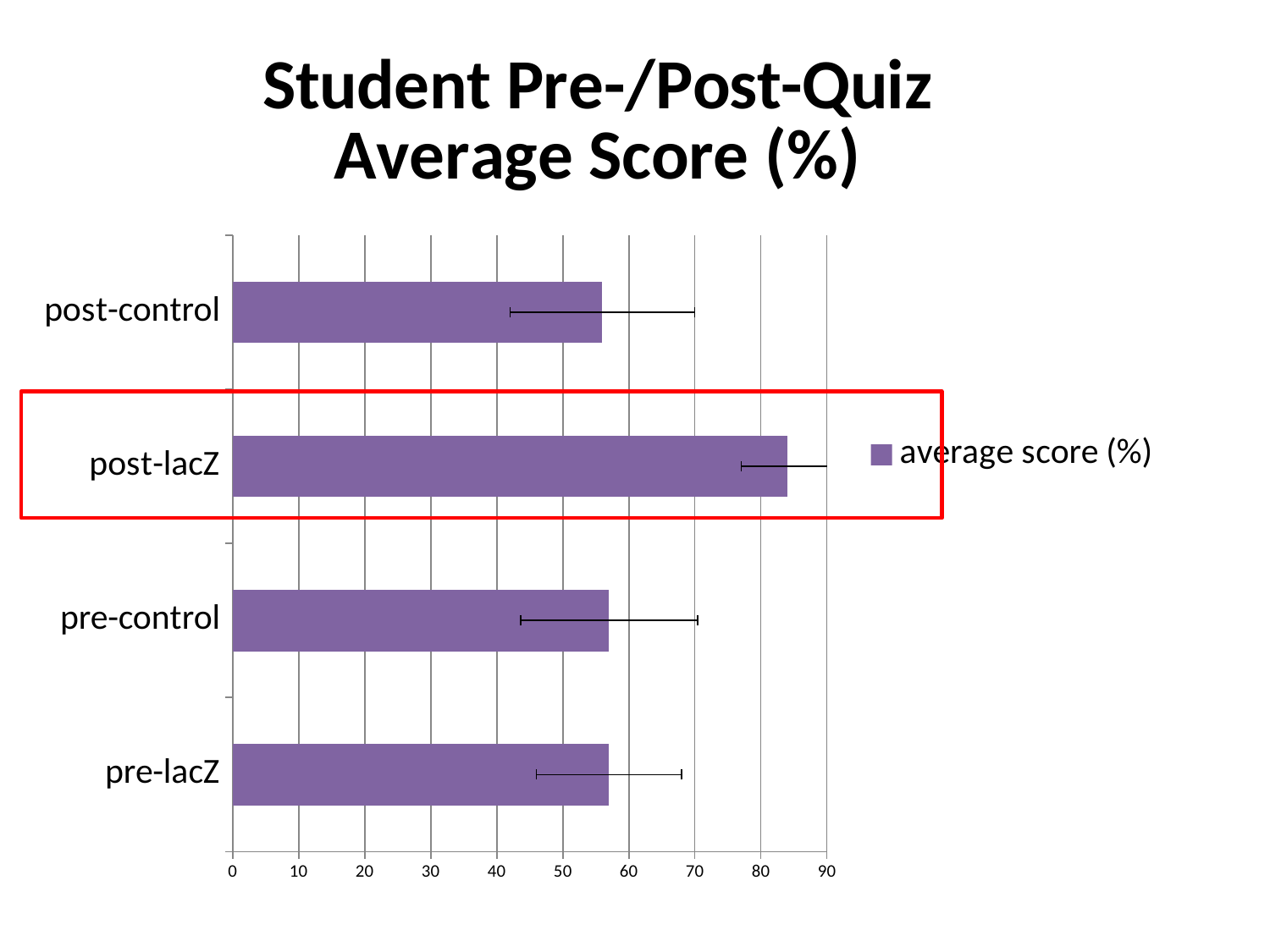
What kind of chart is shown on the slide? bar chart Which is larger, the value for post-lacZ or the value for pre-lacZ? post-lacZ How many series does the legend list? 1 Which category has the highest average score? post-lacZ Is the value for pre-control greater or less than 50? greater What is the name of the series shown in the legend? average score (%) How many categories are plotted in the chart? 4 Which is larger, the value for post-control or the value for post-lacZ? post-lacZ Is the value for pre-lacZ greater or less than 60? less Is the value for post-lacZ greater or less than 80? greater What is the title of the chart? Student Pre-/Post-Quiz Average Score (%)